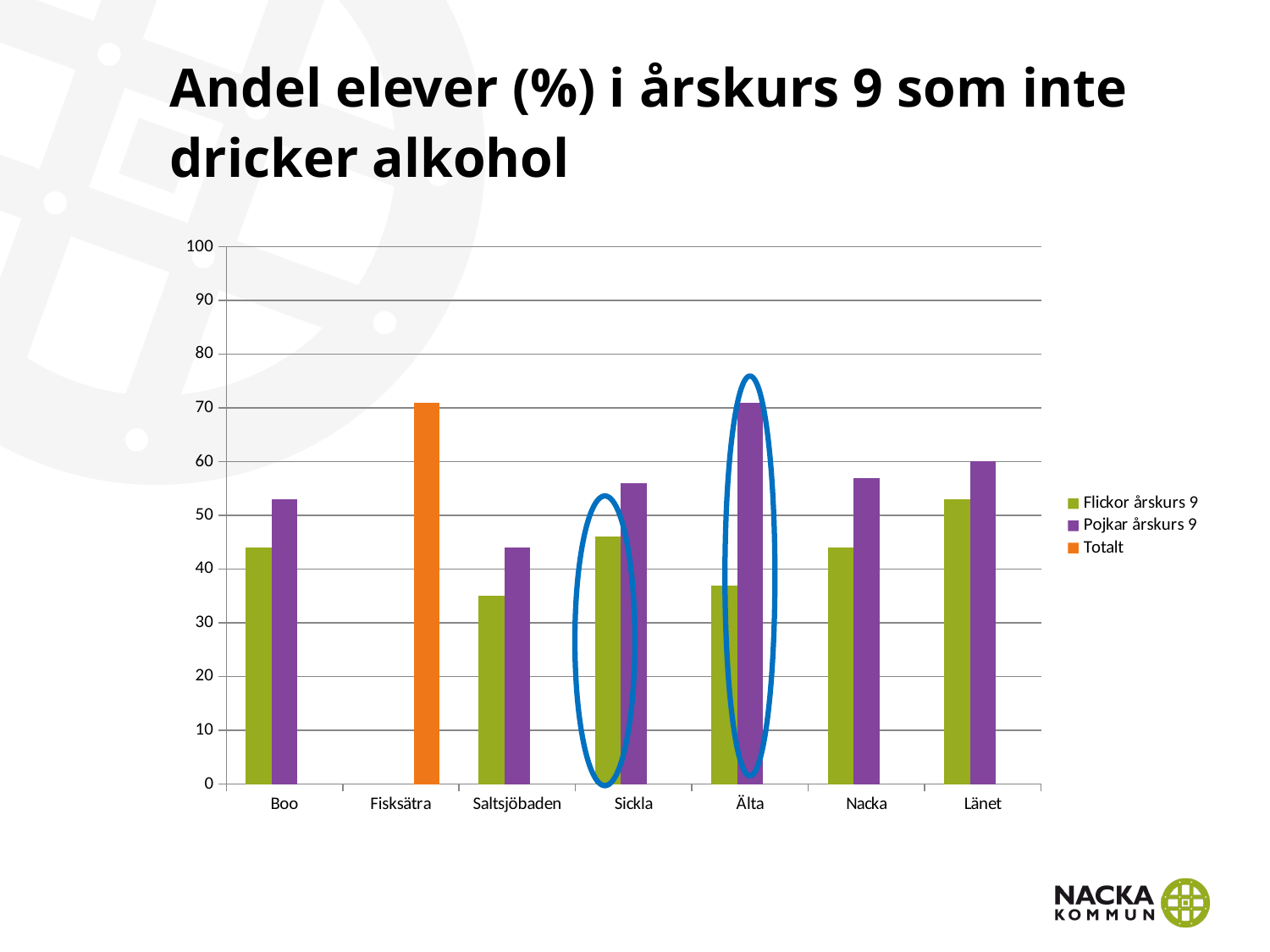
How many series does the legend list? 3 Which category shows only a Totalt bar? Fisksätra Which category has the highest value for Pojkar årskurs 9? Älta Which is larger: Flickor årskurs 9 in Länet or Flickor årskurs 9 in Boo? Länet What kind of chart is shown on the slide? bar chart In Sickla, which is larger: Flickor årskurs 9 or Pojkar årskurs 9? Pojkar årskurs 9 Which category has the highest value for Flickor årskurs 9? Länet How many categories are shown on the x axis? 7 Is the value for Pojkar årskurs 9 in Älta greater or less than 60? greater Is the value for Flickor årskurs 9 in Saltsjöbaden greater or less than 40? less Is the value for Totalt in Fisksätra greater or less than 60? greater